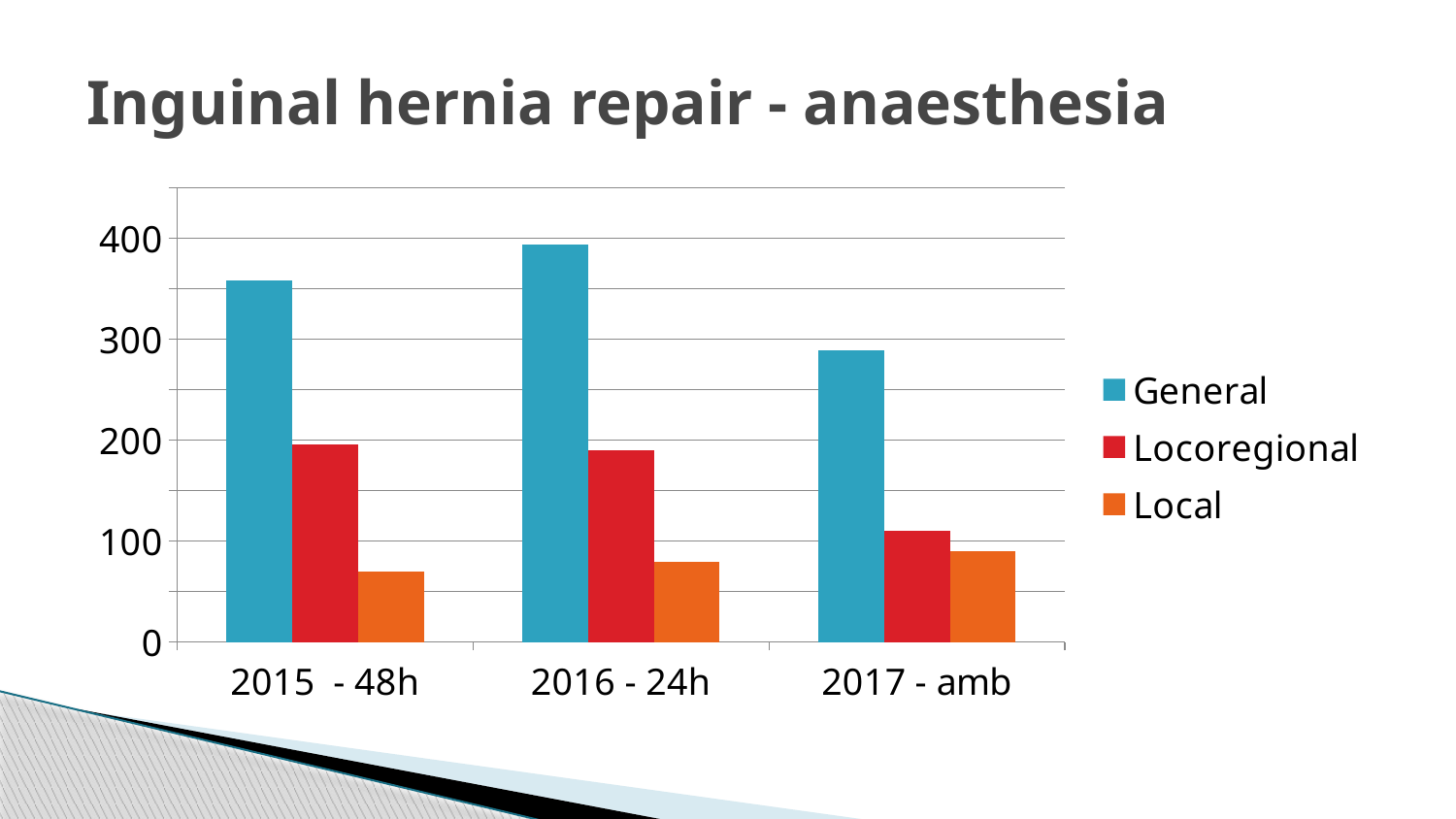
Do the Local values rise or fall from 2015 - 48h to 2017 - amb? rise In which category is the Locoregional series lowest? 2017 - amb In which category is the General series lowest? 2017 - amb Which is larger in 2017 - amb: Locoregional or Local? Locoregional How many categories are shown on the x axis? 3 What kind of chart is shown on the slide? bar chart Is the value for Local in 2015 - 48h greater or less than 100? less Is the value for General in 2017 - amb greater or less than 300? less In which category is the General series highest? 2016 - 24h How many series does the legend list? 3 What is the title of the chart? Inguinal hernia repair - anaesthesia Is the value for General in 2016 - 24h greater or less than 300? greater